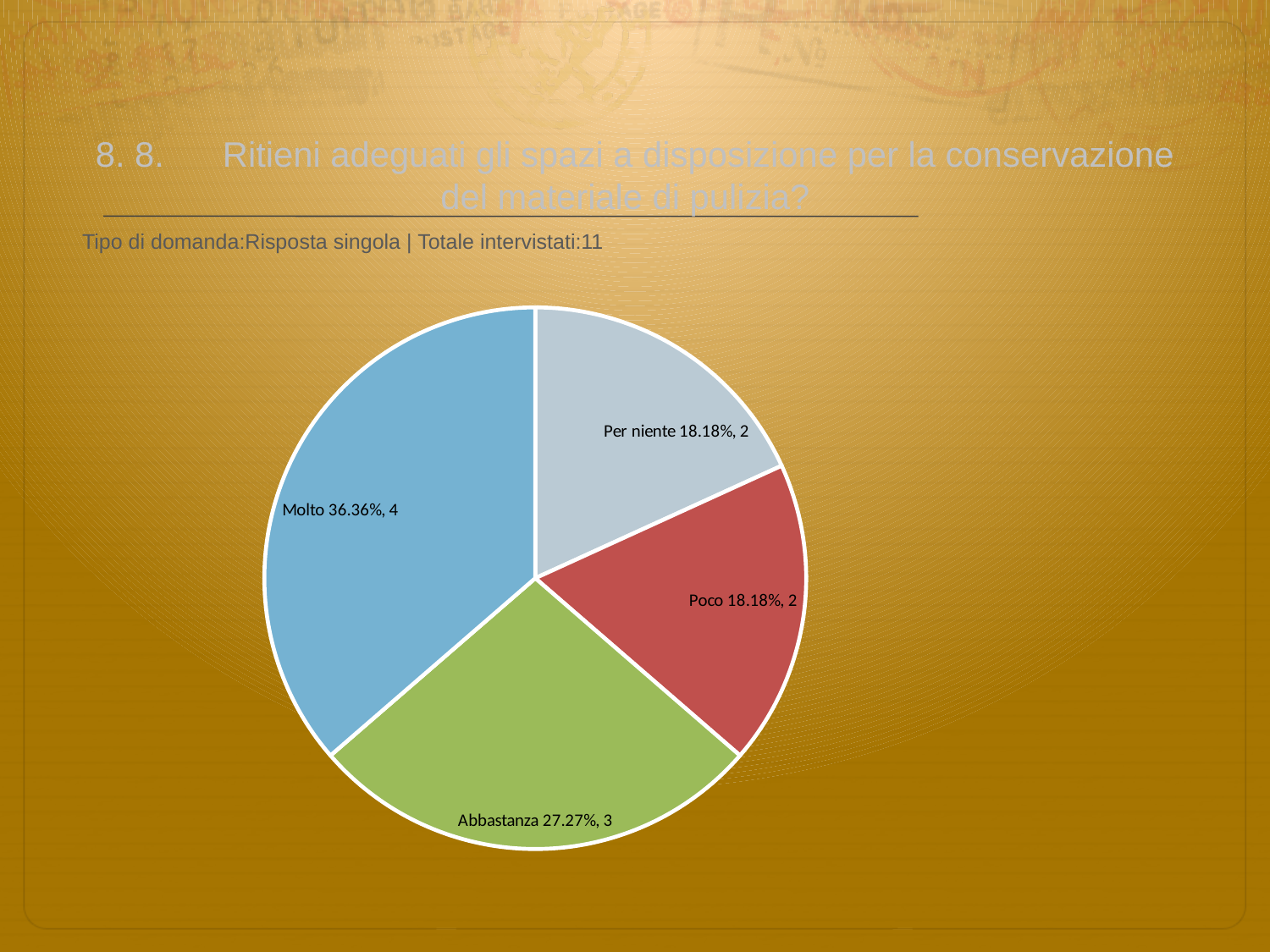
How many respondents answered "Per niente"? 2 Which category has the largest slice of the pie? Molto What colour is the "Abbastanza" slice? green What is the total number of interviewees stated on the slide? 11 Which of the two is larger: the "Abbastanza" slice or the "Poco" slice? Abbastanza What kind of chart is shown on the slide? pie chart What percentage share does the "Molto" slice have? 36.36% What is the total number of respondents across all slices? 11 How many slices does the pie chart have? 4 How many respondents answered "Abbastanza"? 3 What is the difference in number of respondents between "Molto" and "Per niente"? 2 What percentage share does the "Poco" slice have? 18.18%